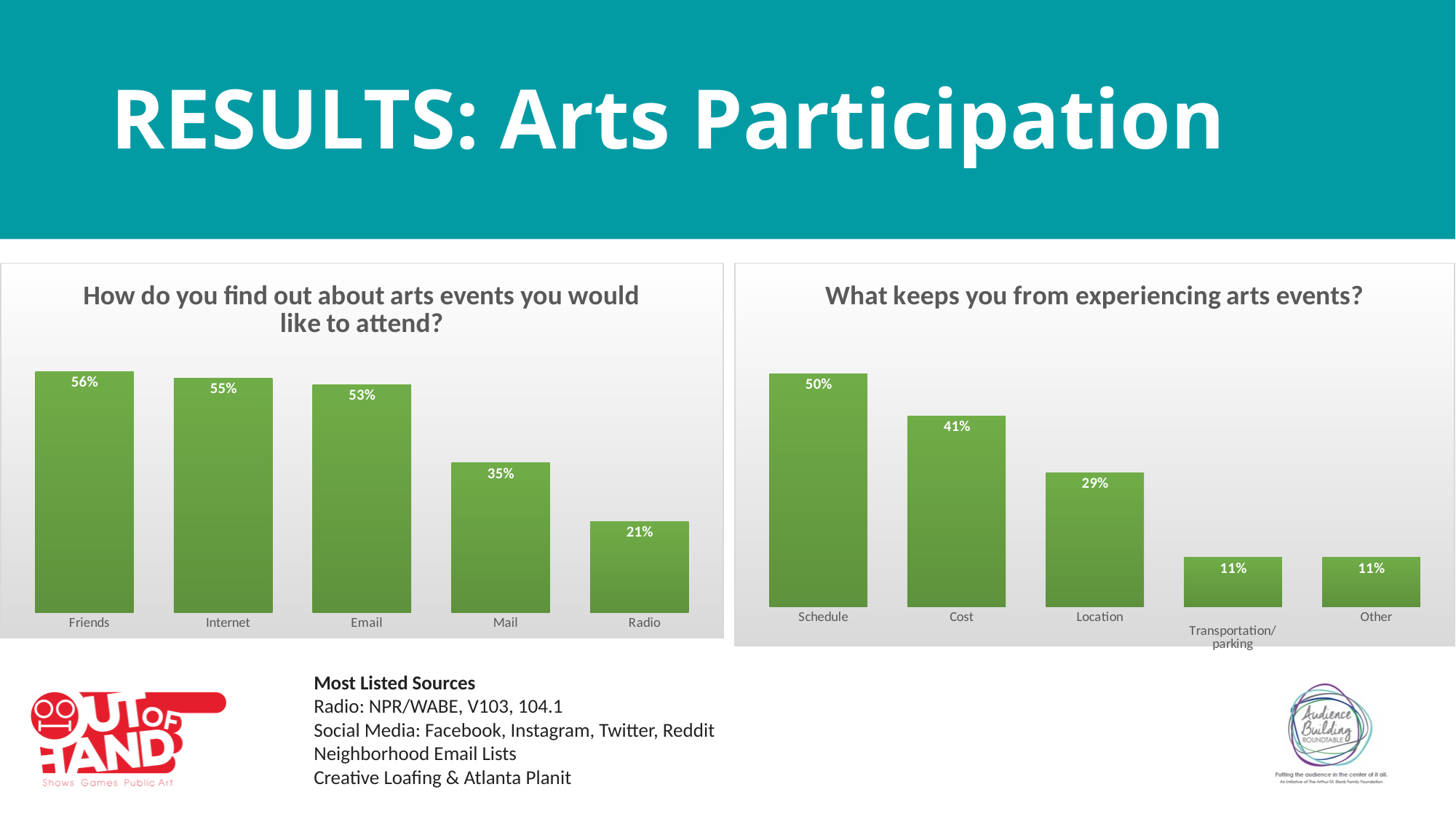
In the chart 'What keeps you from experiencing arts events?', which is larger, the value for Cost or the value for Location? Cost In the chart 'What keeps you from experiencing arts events?', what is the difference between the values for Schedule and Location? 21% In the chart 'How do you find out about arts events you would like to attend?', what is the difference between the values for Friends and Mail? 21% What is the title of the chart on the left side of the slide? How do you find out about arts events you would like to attend? In the chart 'How do you find out about arts events you would like to attend?', what is the value for Email? 53% In the chart 'What keeps you from experiencing arts events?', which category has the highest value? Schedule In the chart 'What keeps you from experiencing arts events?', what is the value for Transportation/parking? 11% In the chart 'How do you find out about arts events you would like to attend?', how many categories are shown? 5 What kind of chart is the chart 'What keeps you from experiencing arts events?'? bar chart In the chart 'How do you find out about arts events you would like to attend?', which category has the lowest value? Radio In the chart 'How do you find out about arts events you would like to attend?', do the values rise or fall from left to right? fall In the chart 'What keeps you from experiencing arts events?', what is the value for Cost? 41%